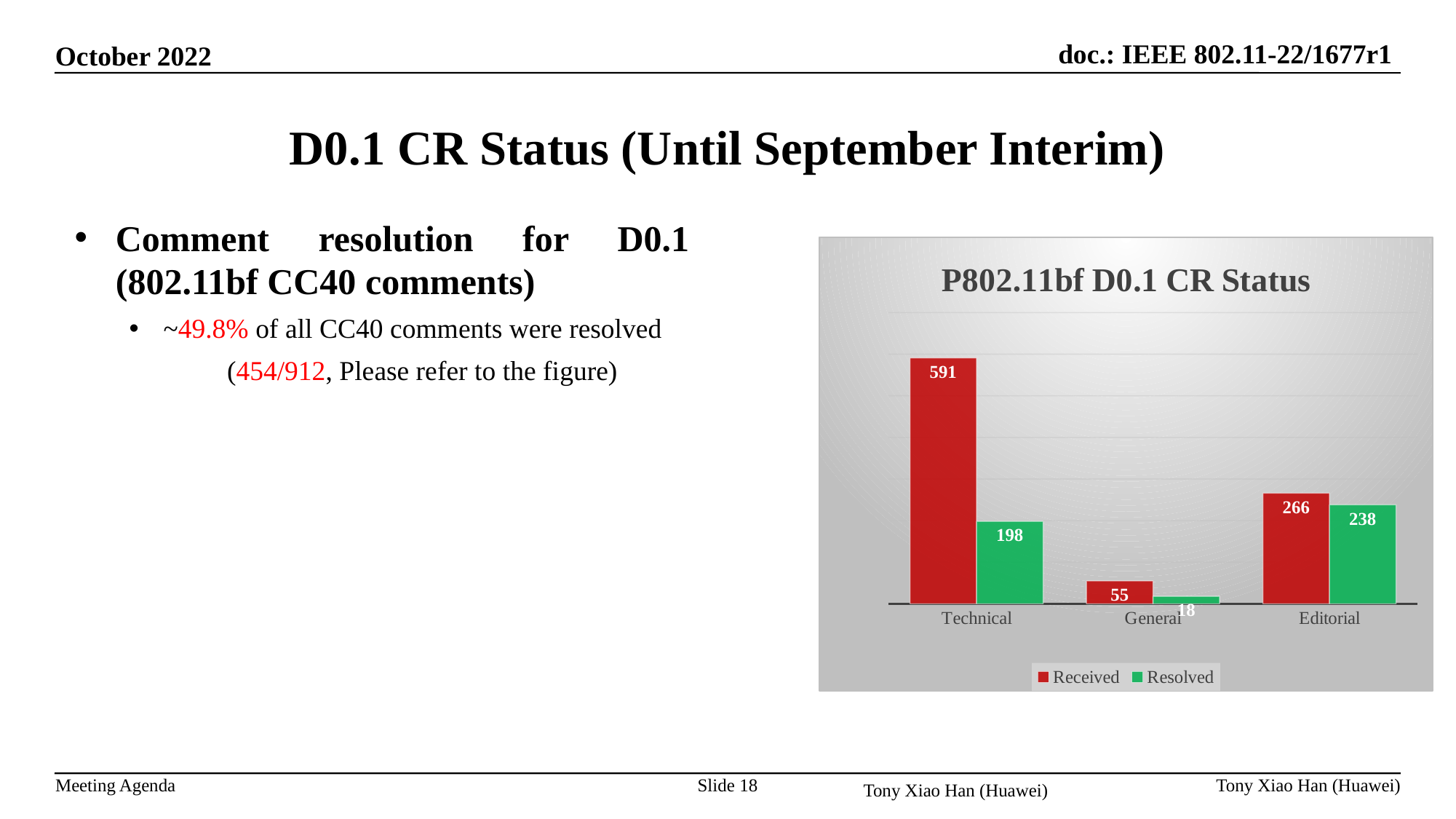
What is the title of the chart? P802.11bf D0.1 CR Status Which category has the lowest number of resolved comments? General Which category has the highest number of received comments? Technical What is the difference between received and resolved Editorial comments? 28 How many Technical comments were received? 591 How many Editorial comments were resolved? 238 How many series does the legend list? 2 What kind of chart is shown on the slide? Bar chart How many General comments were received? 55 Which is larger: resolved Technical comments or resolved Editorial comments? Resolved Editorial comments How many categories are shown on the x axis? 3 What is the difference between received and resolved Technical comments? 393